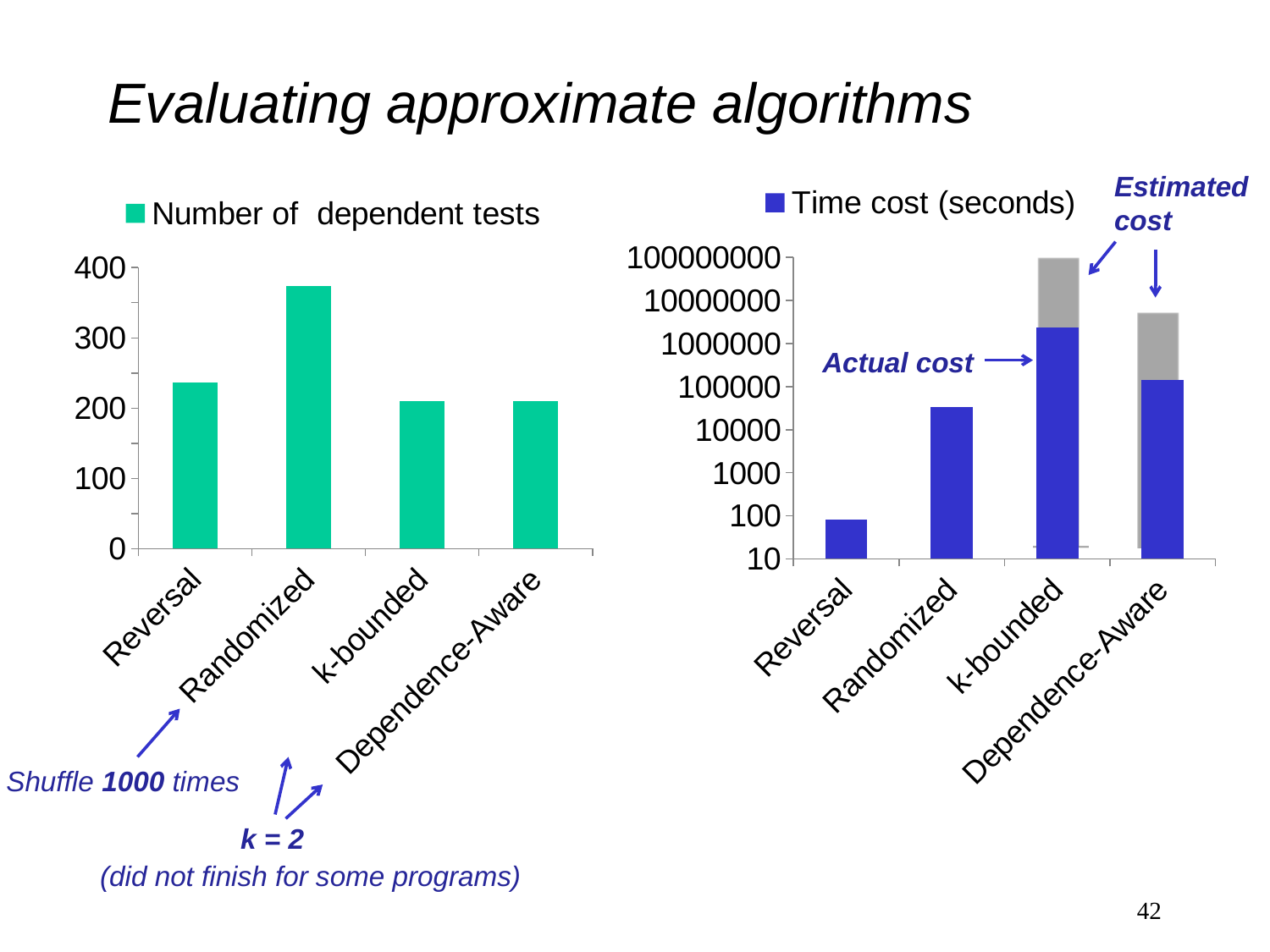
On the right chart (Time cost (seconds)), which category has the lowest time cost? Reversal What kind of chart is the left chart (Number of dependent tests)? bar chart What is the legend entry shown above the right chart? Time cost (seconds) On the left chart (Number of dependent tests), which is larger, the value for Randomized or the value for Reversal? Randomized On the right chart (Time cost (seconds)), is the value for Randomized greater or less than 10000? greater On the right chart (Time cost (seconds)), which category has the highest actual time cost (blue bar)? k-bounded On the right chart (Time cost (seconds)), which is larger, the blue bar for Randomized or the blue bar for Dependence-Aware? Dependence-Aware On the left chart (Number of dependent tests), is the value for Reversal greater or less than 300? less On the left chart (Number of dependent tests), is the value for Randomized greater or less than 300? greater On the left chart (Number of dependent tests), how many categories are shown on the x axis? 4 On the left chart (Number of dependent tests), which category has the highest value? Randomized